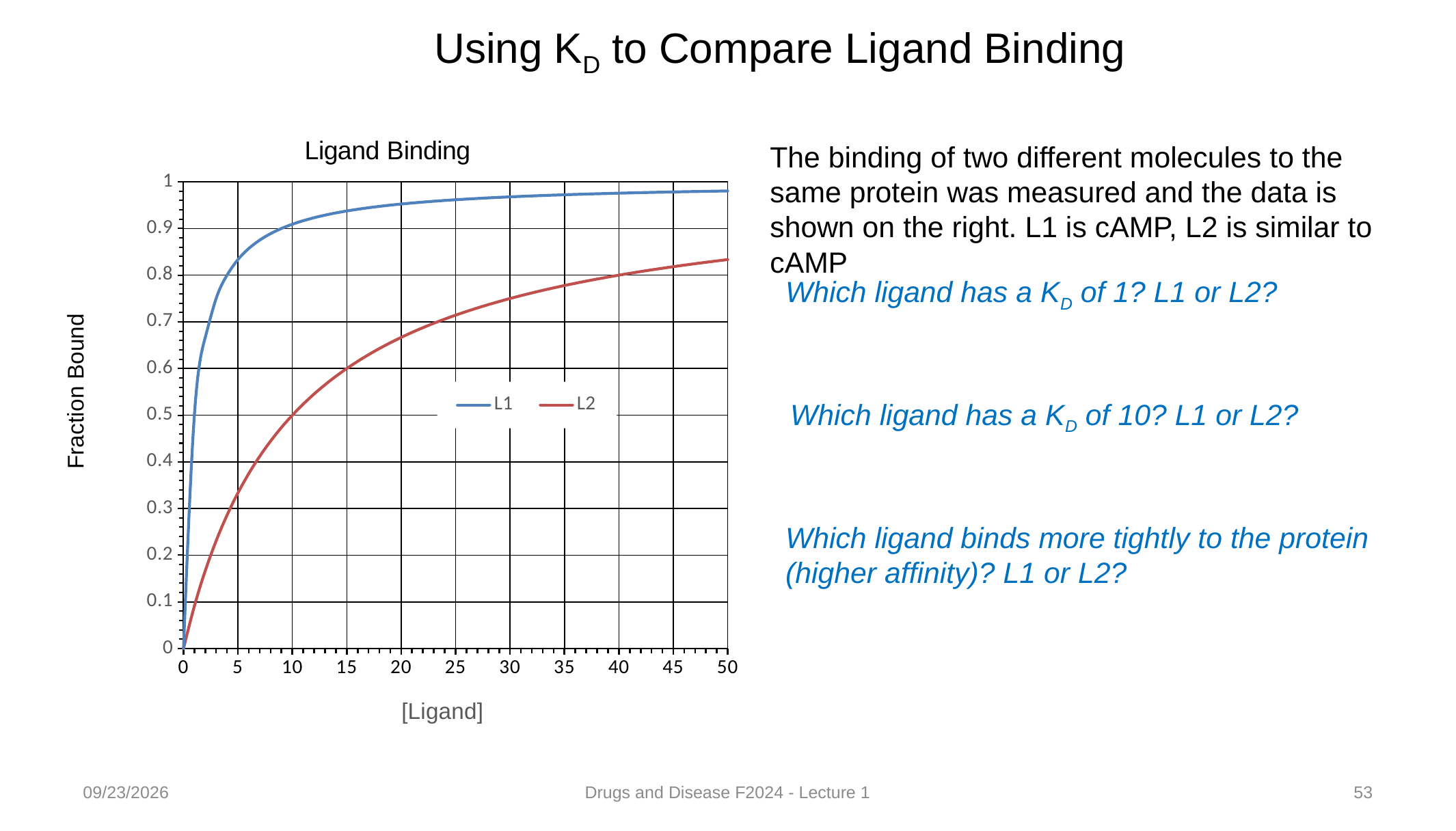
What is the label of the vertical axis of the Ligand Binding chart? Fraction Bound In the Ligand Binding chart, which series has the higher Fraction Bound at a [Ligand] of 40, L1 or L2? L1 In the Ligand Binding chart, is the Fraction Bound for L1 at a [Ligand] of 5 greater or less than 0.8? greater In the Ligand Binding chart, is the Fraction Bound for L1 at a [Ligand] of 50 greater or less than 0.9? greater In the Ligand Binding chart, is the Fraction Bound for L2 at a [Ligand] of 5 greater or less than 0.4? less In the Ligand Binding chart, does the Fraction Bound for L2 rise or fall as [Ligand] increases? Rises How many series does the legend of the Ligand Binding chart list? 2 What is the title of the chart on the slide? Ligand Binding In the Ligand Binding chart, which series has the higher Fraction Bound at a [Ligand] of 10, L1 or L2? L1 What kind of chart is shown on the slide? Line chart